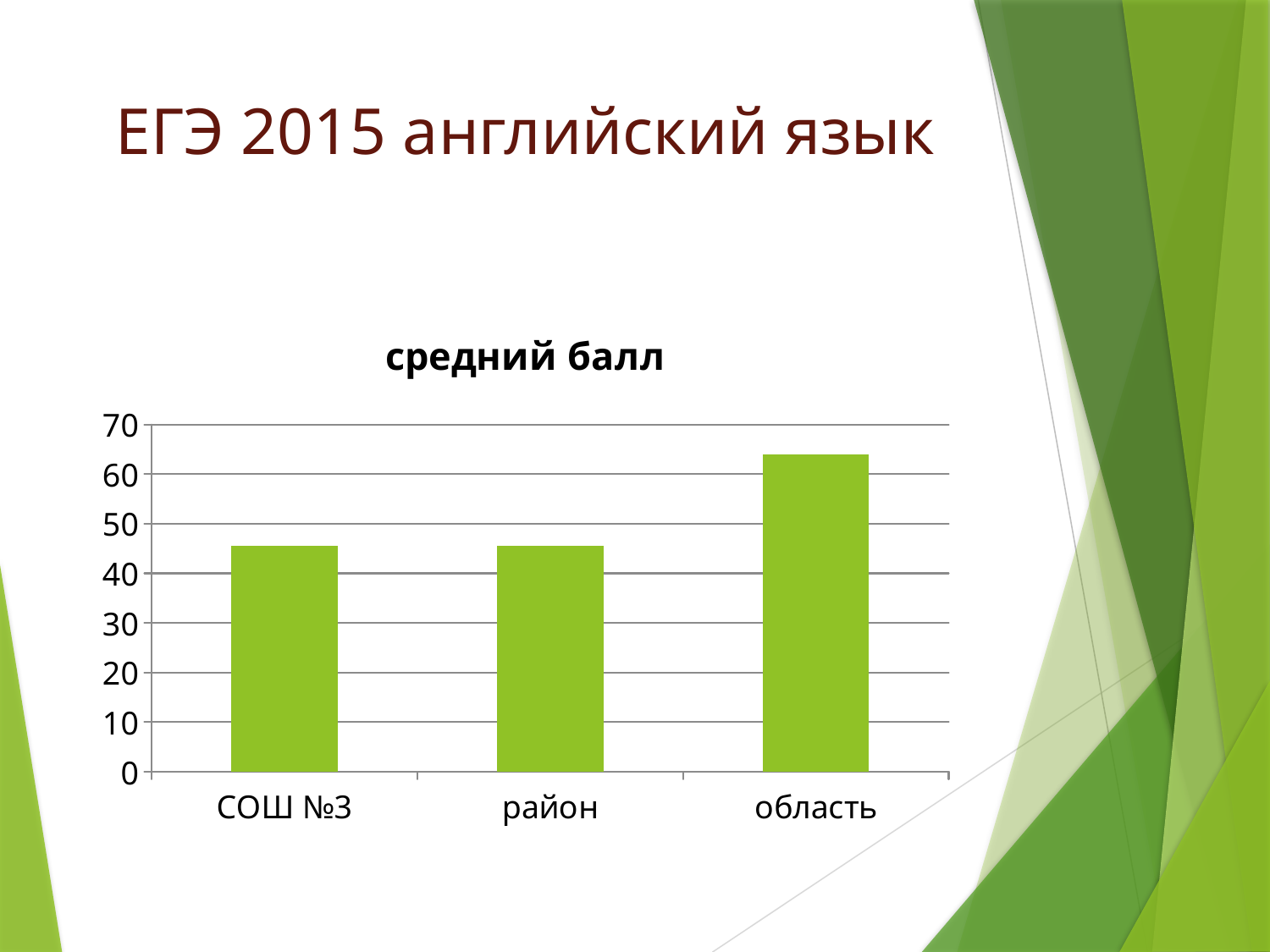
What is the title of the chart? средний балл Is the value for район greater or less than 40? greater Which category has the highest value in the chart? область Is the value for СОШ №3 greater or less than 30? greater Is the value for область greater or less than 70? less Which is larger, the value for СОШ №3 or the value for область? область What is the highest value shown on the y axis of the chart? 70 Which is larger, the value for область or the value for район? область How many categories are shown on the x axis of the chart? 3 What type of chart is shown on the slide? bar chart